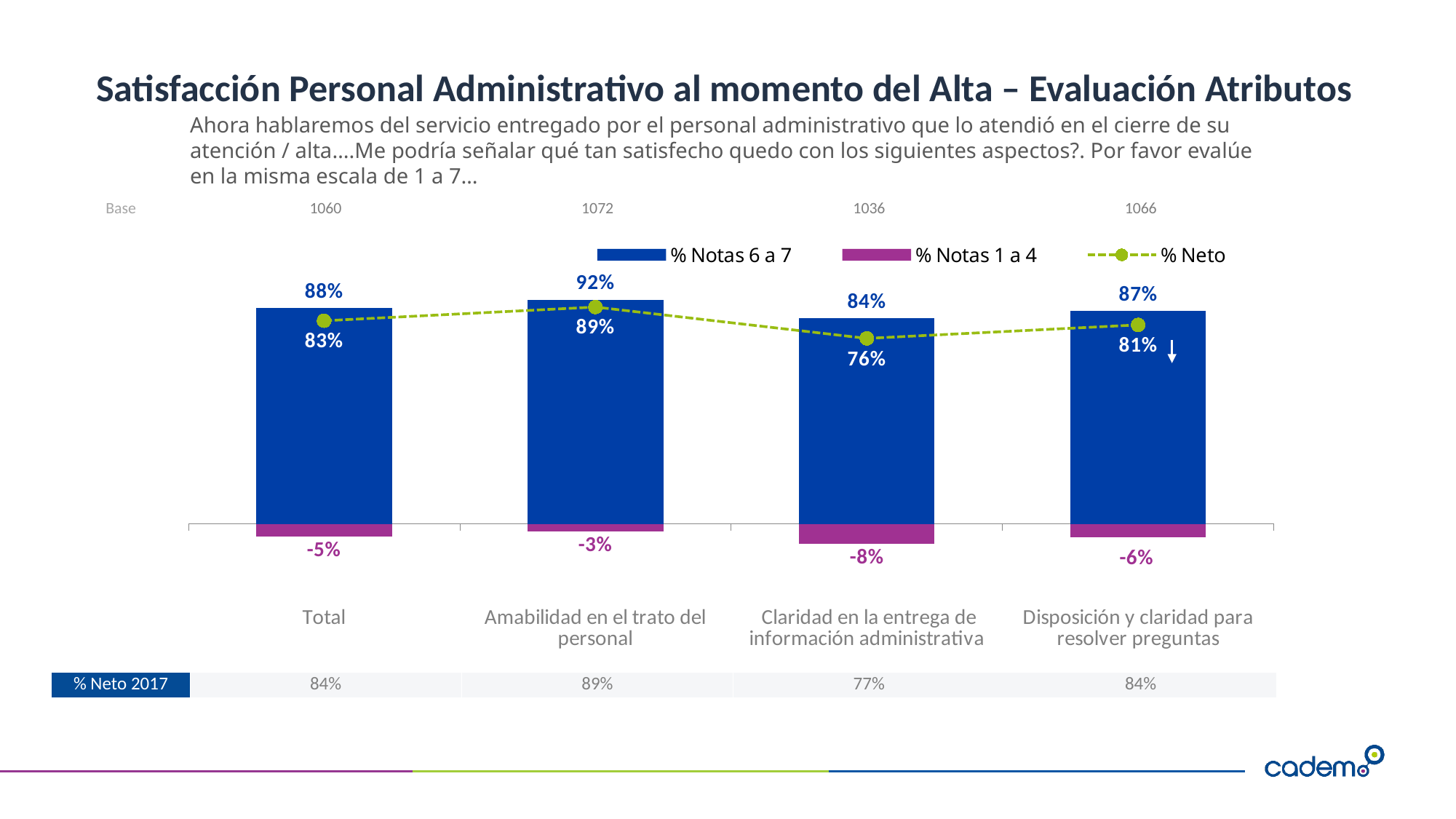
What is the difference between the % Notas 6 a 7 values for Amabilidad en el trato del personal and Claridad en la entrega de información administrativa? 8% What kind of chart is shown on the slide? Bar chart with a line What is the % Notas 1 a 4 value for Claridad en la entrega de información administrativa? -8% What is the % Notas 6 a 7 value for Amabilidad en el trato del personal? 92% Which is larger, the % Neto for Total or the % Neto for Disposición y claridad para resolver preguntas? Total What is the % Neto value for Total? 83% Which category has the lowest % Neto value? Claridad en la entrega de información administrativa How many series does the legend list? 3 Which category has the highest % Notas 6 a 7 value? Amabilidad en el trato del personal What is the % Neto value for Disposición y claridad para resolver preguntas? 81% How many categories are shown on the x axis of the chart? 4 What is the % Neto 2017 value shown for Claridad en la entrega de información administrativa? 77%